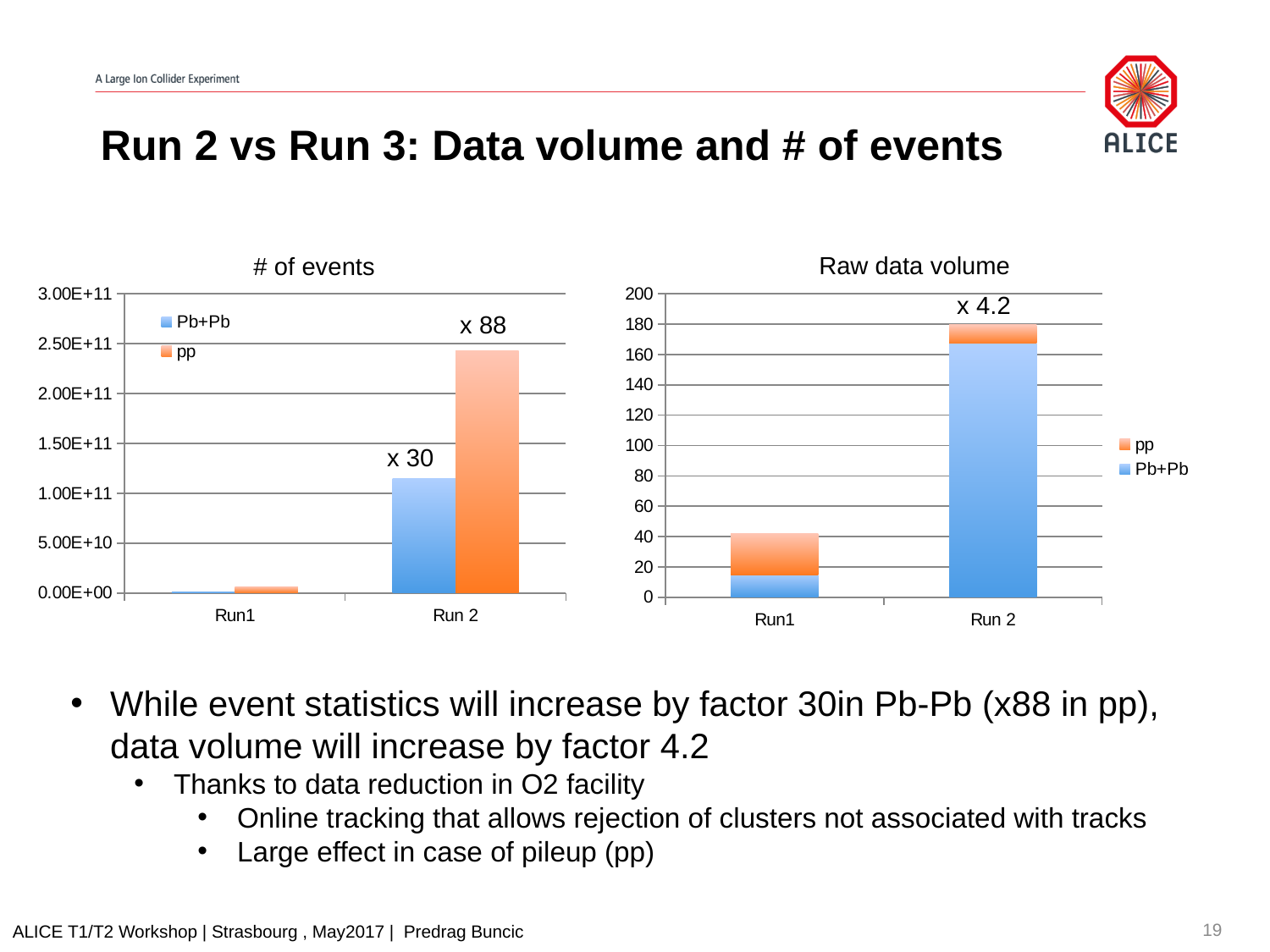
In the '# of events' chart, which is larger for Run 2: Pb+Pb or pp? pp In the '# of events' chart, is the Pb+Pb value for Run 2 greater or less than 1.00E+11? greater What kind of chart is the 'Raw data volume' chart? bar chart In the '# of events' chart, is the pp value for Run 2 greater or less than 2.00E+11? greater In the '# of events' chart, how many series does the legend list? 2 In the 'Raw data volume' chart, is the Pb+Pb value for Run 2 greater or less than 140? greater In the 'Raw data volume' chart, what annotation is printed above the Run 2 bar? x 4.2 In the '# of events' chart, which bar is the highest? pp in Run 2 In the '# of events' chart, what annotation is printed above the pp bar for Run 2? x 88 In the '# of events' chart, how many categories are shown on the x axis? 2 What kind of chart is the '# of events' chart? bar chart